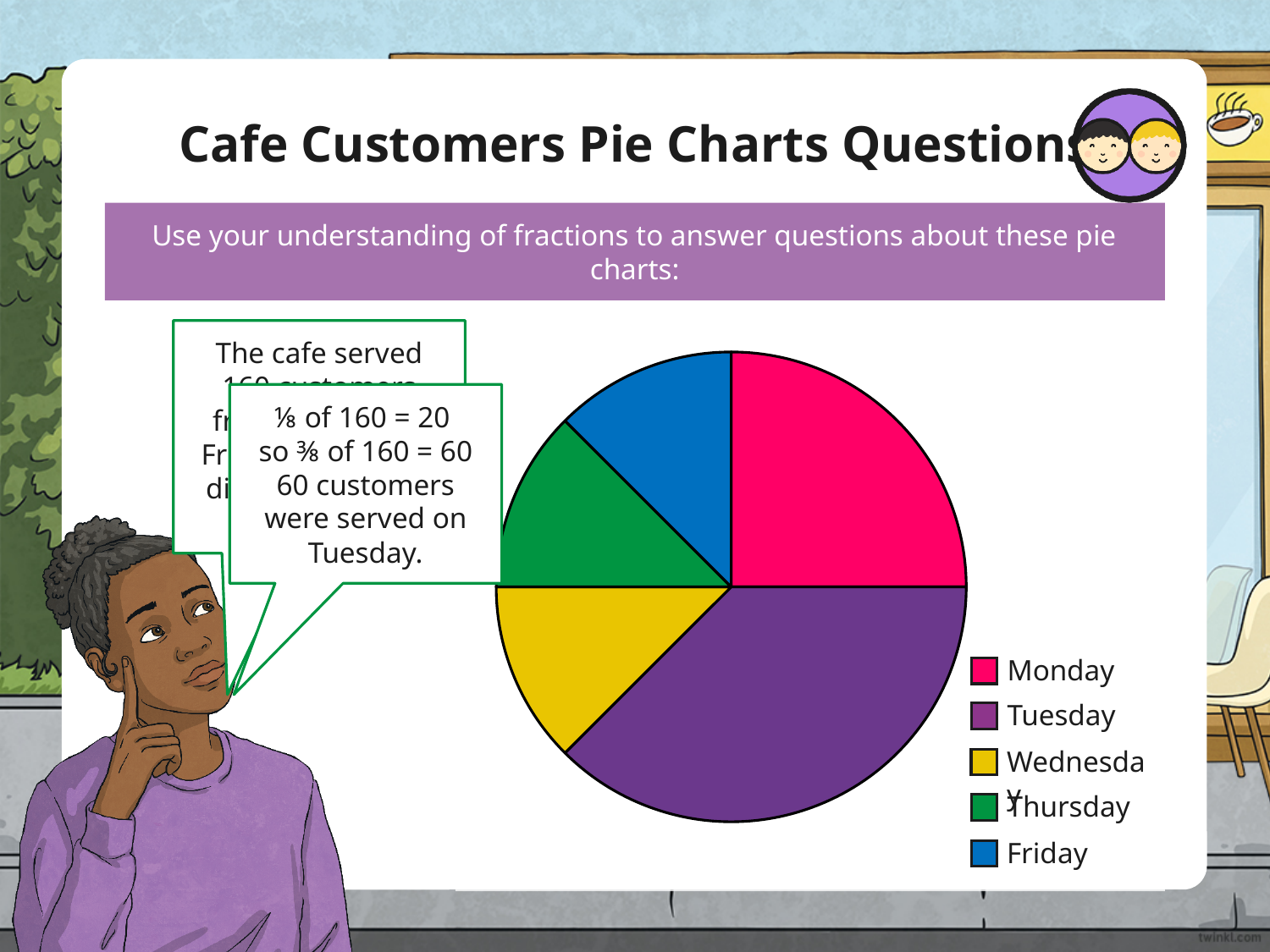
How many entries does the legend list? 5 What kind of chart is shown on the slide? pie chart Which slice is larger, Tuesday or Wednesday? Tuesday Which slice is larger, Monday or Tuesday? Tuesday According to the speech bubble, how many customers were served on Tuesday? 60 Which day has the largest slice of the pie chart? Tuesday According to the speech bubble, how many customers did the cafe serve in total? 160 According to the speech bubble, what fraction of the customers were served on Tuesday? ⅜ How many slices does the pie chart have? 5 What is the title of the slide? Cafe Customers Pie Charts Questions What colour is the Monday slice in the pie chart? pink Which slice is larger, Monday or Friday? Monday